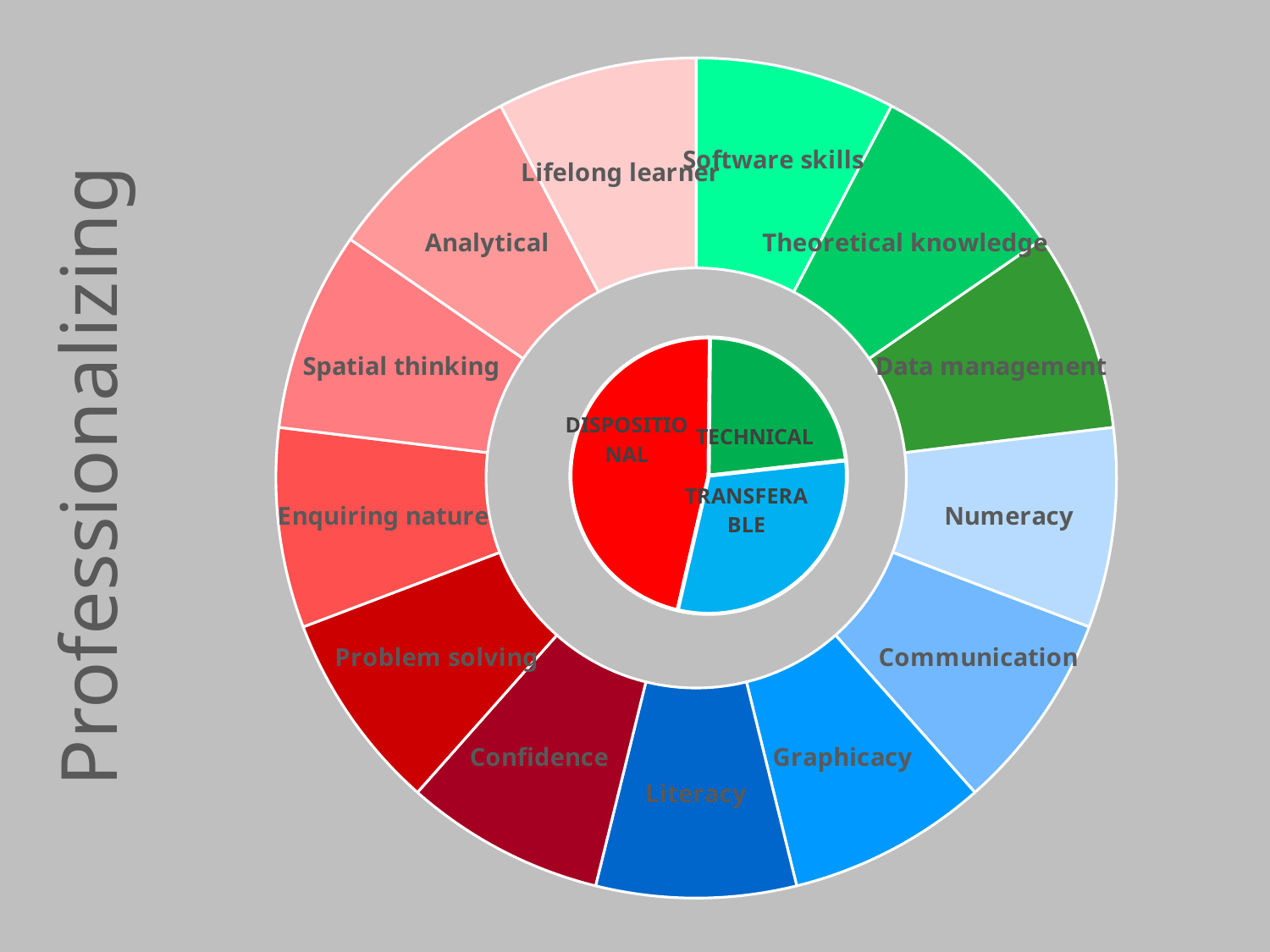
Which inner-ring category does the Numeracy segment belong to? TRANSFERABLE What kind of chart is shown on the slide? sunburst chart How many outer-ring segments belong to the TRANSFERABLE category? 4 How many categories are in the inner ring of the chart? 3 How many outer-ring segments belong to the DISPOSITIONAL category? 6 What colour are the TECHNICAL segments of the chart? green Which inner-ring category does the Data management segment belong to? TECHNICAL Which is larger in the inner ring, DISPOSITIONAL or TECHNICAL? DISPOSITIONAL Which inner-ring category takes up the largest share of the chart? DISPOSITIONAL What is the title text shown on the slide? Professionalizing